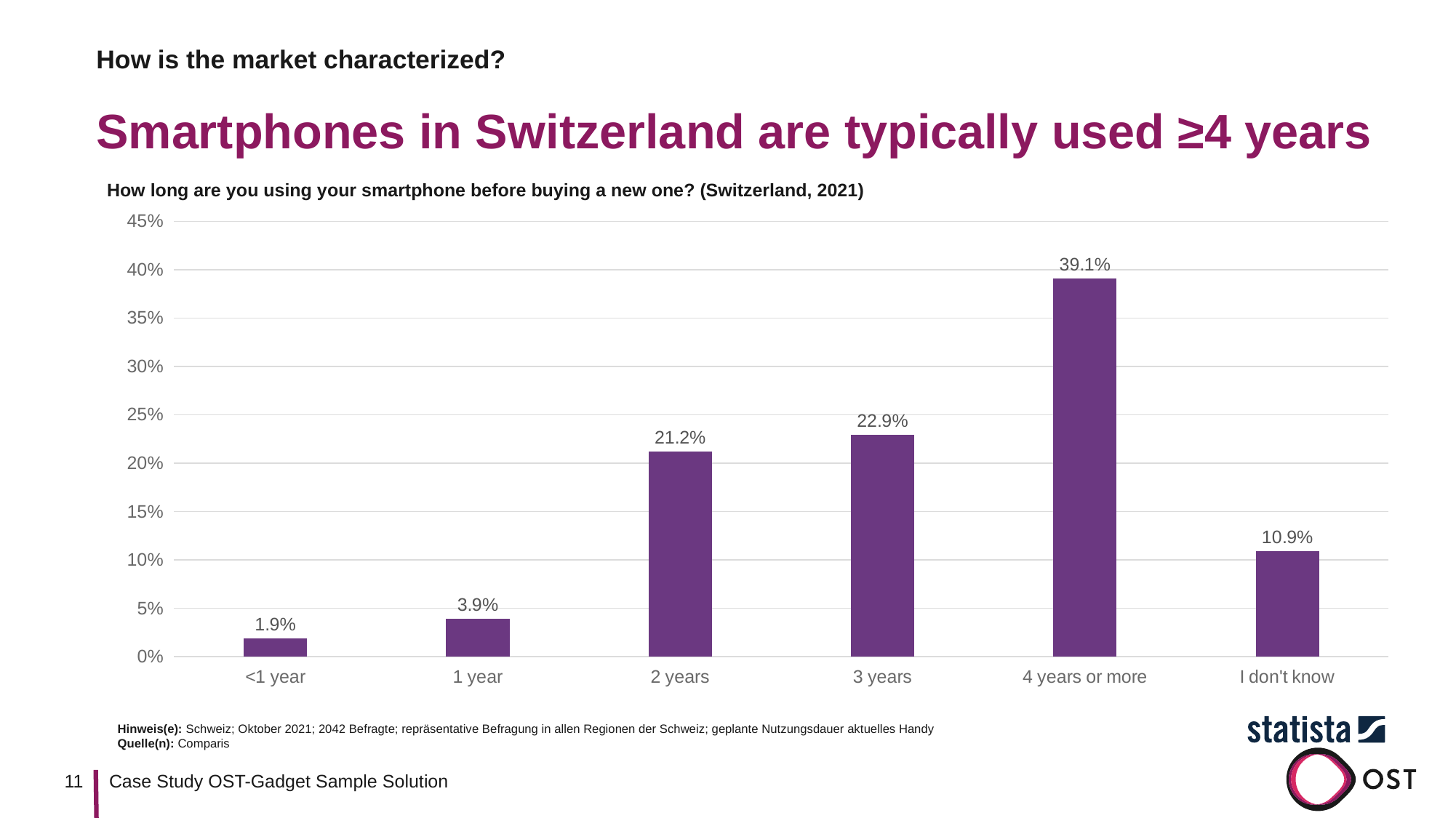
Which category has the lowest value? <1 year What is the combined value of '<1 year' and '1 year'? 5.8% What percentage of respondents answered 'I don't know'? 10.9% Is the value for '4 years or more' greater or less than 35%? greater Which category has the highest value? 4 years or more What is the difference between the values for '3 years' and '2 years'? 1.7% How many categories are shown on the x axis? 6 What kind of chart is shown on the slide? Bar chart What is the title of the chart? How long are you using your smartphone before buying a new one? (Switzerland, 2021) Which is larger, the value for '1 year' or the value for 'I don't know'? I don't know What percentage of respondents use their smartphone for 4 years or more before buying a new one? 39.1% What is the value shown for the '2 years' category? 21.2%